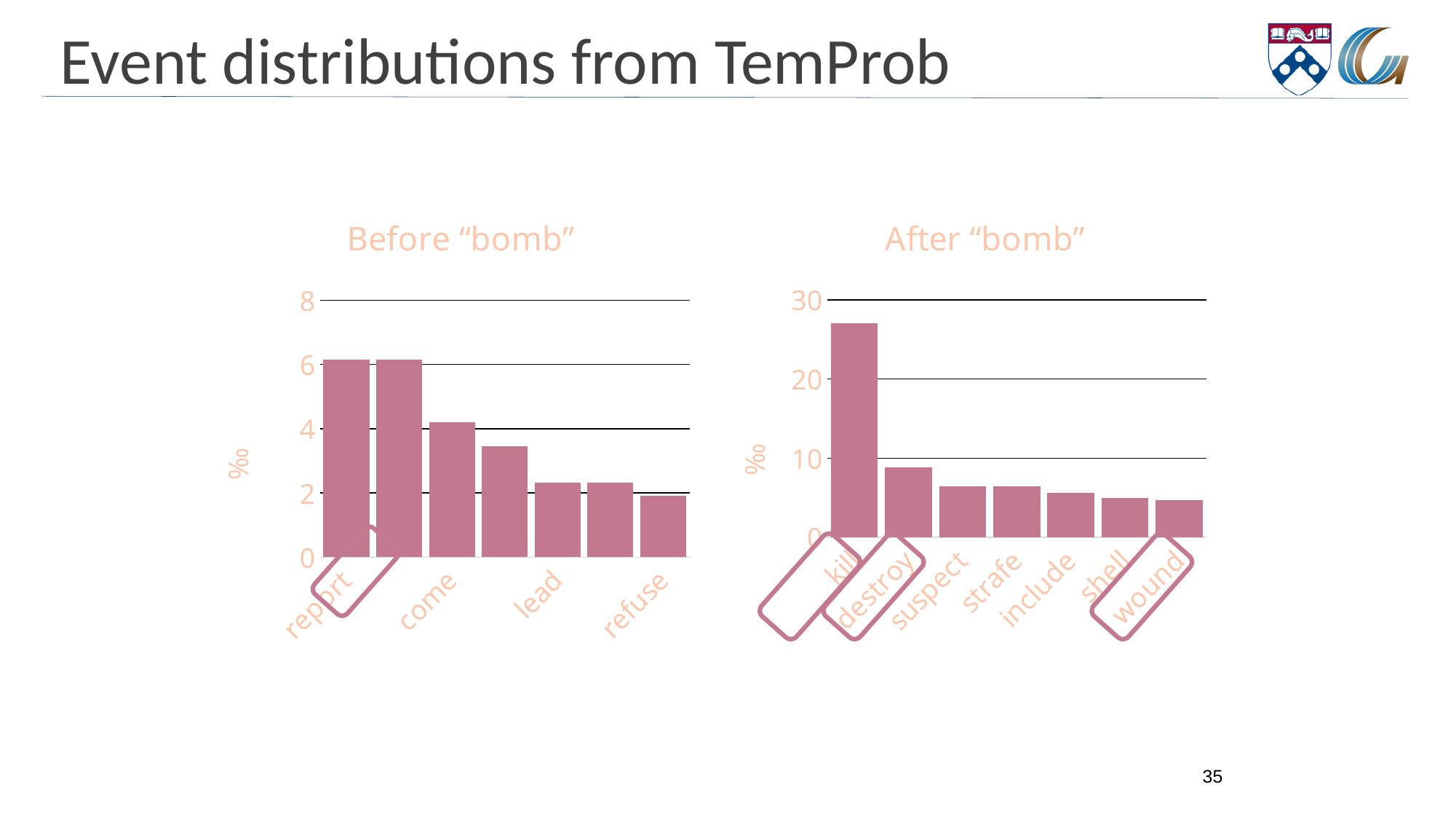
What kind of chart is used for the "Before "bomb"" chart? bar chart In the "After "bomb"" chart, which event has the highest value? kill In the "Before "bomb"" chart, which is larger, the value for report or the value for come? report In the "Before "bomb"" chart, is the value for report greater or less than 4? greater What unit is shown on the y axis of the "After "bomb"" chart? ‰ In the "Before "bomb"" chart, how many bars are plotted? 7 In the "After "bomb"" chart, how many event categories are plotted? 7 In the "After "bomb"" chart, is the value for kill greater or less than 20? greater In the "After "bomb"" chart, do the values rise or fall from left to right along the x axis? fall In the "After "bomb"" chart, which is larger, the value for kill or the value for destroy? kill In the "Before "bomb"" chart, is the value for lead greater or less than 2? greater